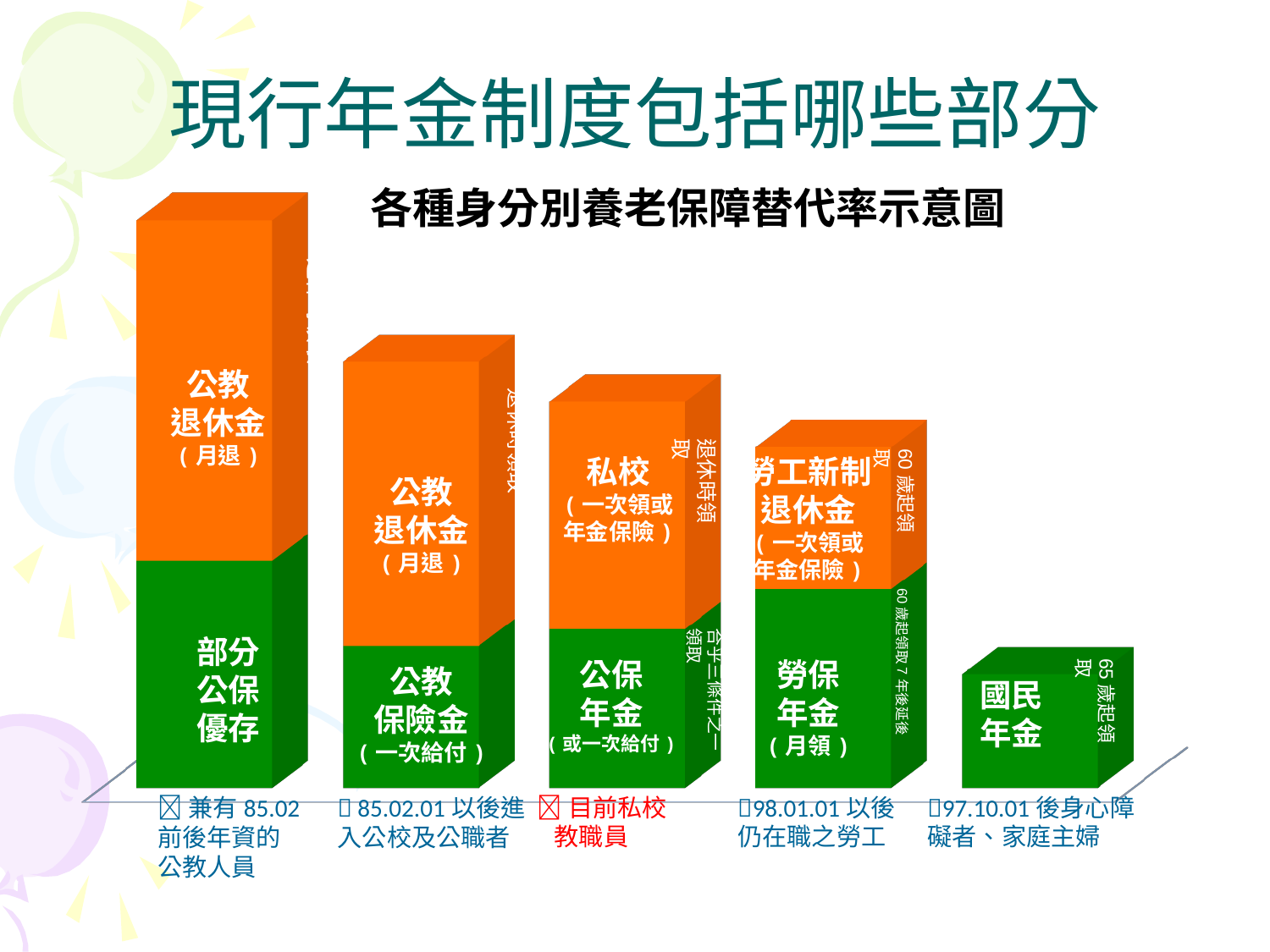
How many segments make up the 國民年金 bar? 1 What is the title of the chart? 各種身分別養老保障替代率示意圖 Which bar is taller: 兼有85.02前後年資的公教人員 or 85.02.01以後進入公校及公職者? 兼有85.02前後年資的公教人員 Which category has the shortest bar? 97.10.01後身心障礙者、家庭主婦 (國民年金) Which category has the tallest bar? 兼有85.02前後年資的公教人員 What is the label of the green (bottom) segment of the 98.01.01以後仍在職之勞工 bar? 勞保年金（月領） How many bars (categories) does the chart show? 5 Which bar is taller: 目前私校教職員 or 98.01.01以後仍在職之勞工? 目前私校教職員 What kind of chart is shown on the slide? Stacked bar chart Do the bar heights rise or fall from left to right across the chart? Fall